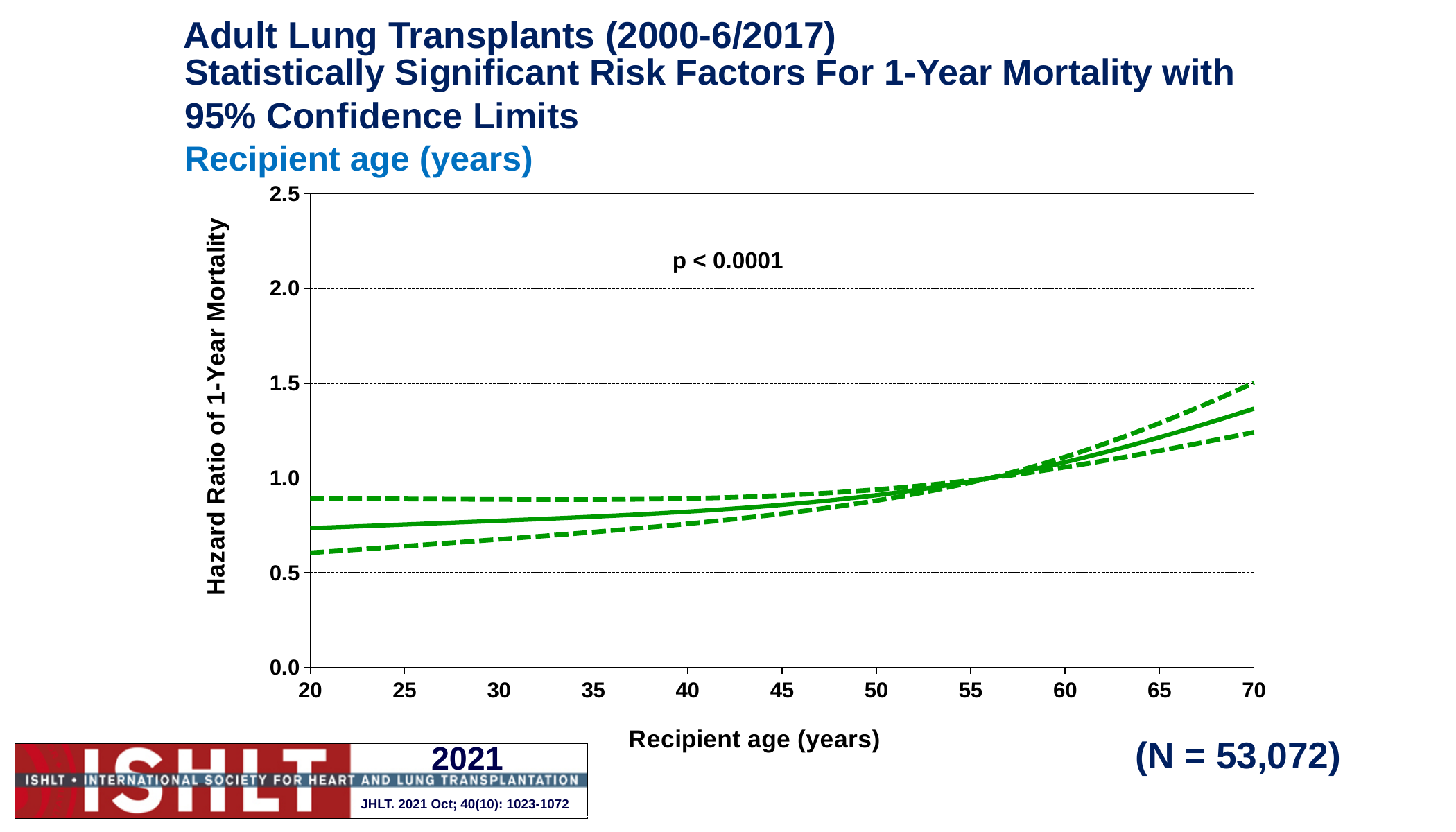
What is the sample size (N) shown on the slide? 53,072 Is the upper 95% confidence limit at recipient age 20 greater or less than 1.0? less What p-value is printed on the chart? p < 0.0001 Does the hazard ratio of 1-year mortality rise or fall as recipient age increases from 20 to 70 years? rise Which has the larger hazard ratio of 1-year mortality: recipient age 20 or recipient age 70? recipient age 70 Is the hazard ratio (solid line) at recipient age 70 greater or less than 1.0? greater Is the lower 95% confidence limit at recipient age 20 greater or less than 0.5? greater How many lines are plotted on the chart? 3 What is the label of the y-axis? Hazard Ratio of 1-Year Mortality What kind of chart is shown on the slide? line chart What is the highest tick value shown on the y-axis? 2.5